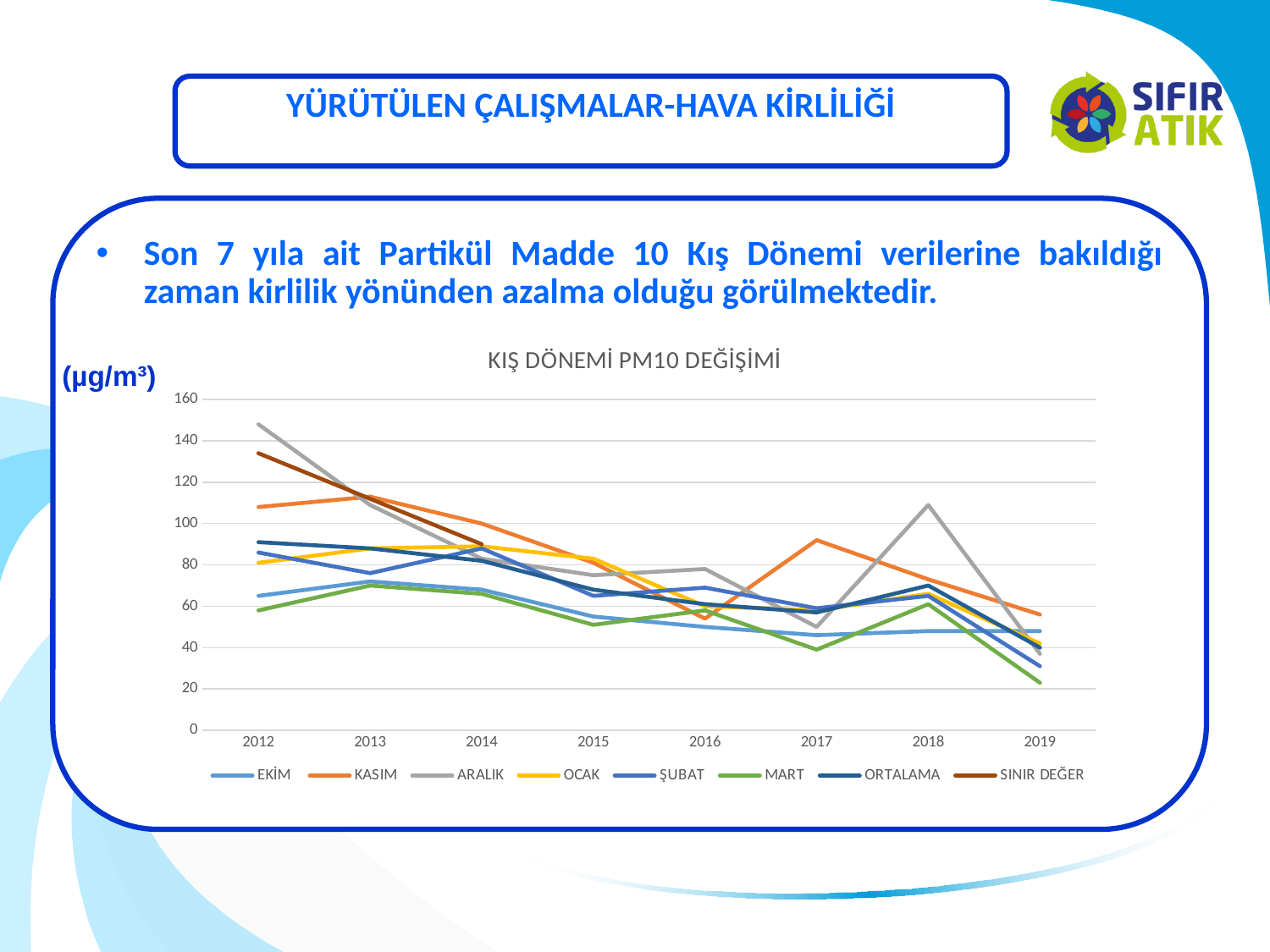
Which series has the highest value in 2012? ARALIK Which series has the lowest value in 2019? MART What is the title of the chart? KIŞ DÖNEMİ PM10 DEĞİŞİMİ Is the value for ARALIK in 2018 greater or less than 100? greater What kind of chart is shown on the slide? line chart In 2018, which is larger: the value for ARALIK or the value for KASIM? ARALIK How many years are shown on the x axis of the chart? 8 What unit is shown for the values on the chart? µg/m³ How many series does the legend of the chart list? 8 Does the ORTALAMA series generally rise or fall from 2012 to 2019? fall Is the value for MART in 2019 greater or less than 40? less Is the value for ARALIK in 2012 greater or less than 140? greater